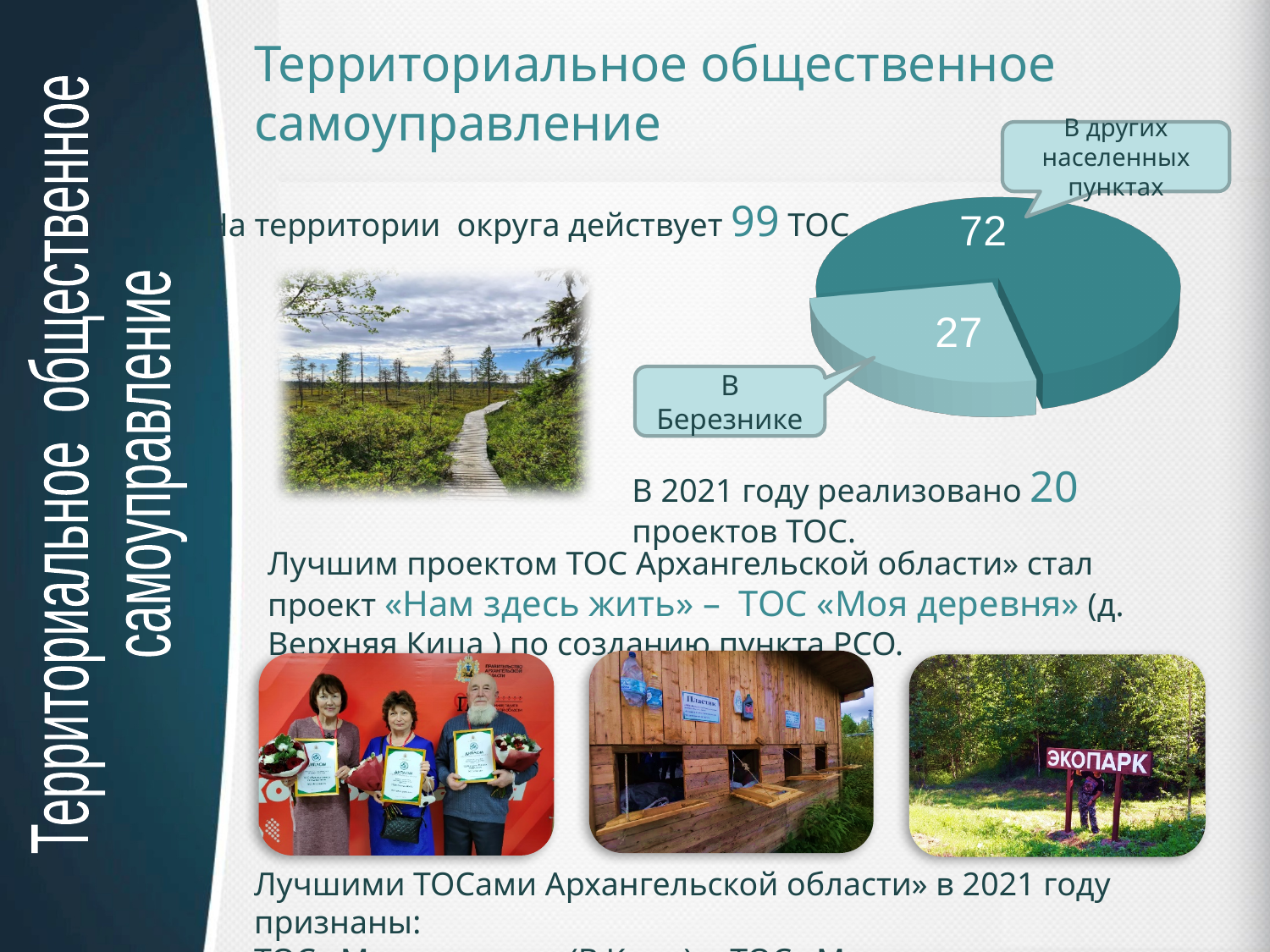
In the pie chart, what value is shown for the slice labelled «В Березнике»? 27 How many slices does the pie chart have? 2 What is the total of the two values shown in the pie chart? 99 What kind of chart is shown on the slide? pie chart Which slice of the pie chart is the largest? В других населенных пунктах In the pie chart, what value is shown for the slice labelled «В других населенных пунктах»? 72 Which is larger in the pie chart: the value for «В Березнике» or the value for «В других населенных пунктах»? В других населенных пунктах How are the slice labels attached to the pie chart? as callout boxes What is the difference between the values of the two slices in the pie chart? 45 Is the value for «В Березнике» in the pie chart greater or less than 50? less Is the value for «В других населенных пунктах» in the pie chart greater or less than 50? greater Which slice of the pie chart is the smallest? В Березнике